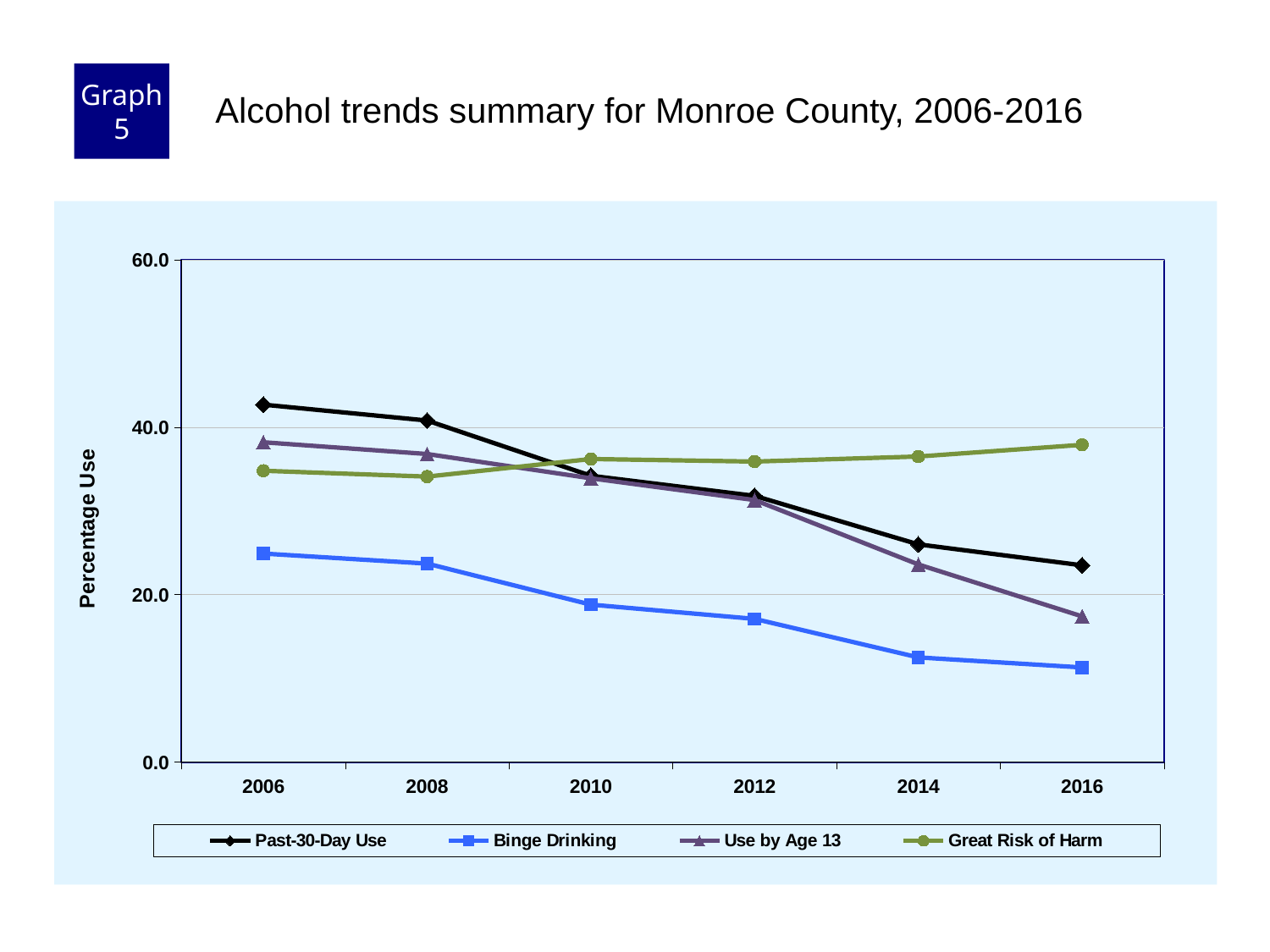
How many series does the legend list? 4 Is the value for Past-30-Day Use in 2006 greater or less than 40.0? greater Does the Great Risk of Harm line rise or fall from 2006 to 2016? Rise In 2006, which is larger: Past-30-Day Use or Great Risk of Harm? Past-30-Day Use Does the Binge Drinking line rise or fall from 2006 to 2016? Fall Which series has the highest value in 2016? Great Risk of Harm Which series has the lowest value in 2006? Binge Drinking What is the label on the vertical axis? Percentage Use Is the value for Use by Age 13 in 2016 greater or less than 20.0? less How many years are plotted along the x axis? 6 Is the value for Binge Drinking in 2016 greater or less than 20.0? less What kind of chart is shown on the slide? Line chart